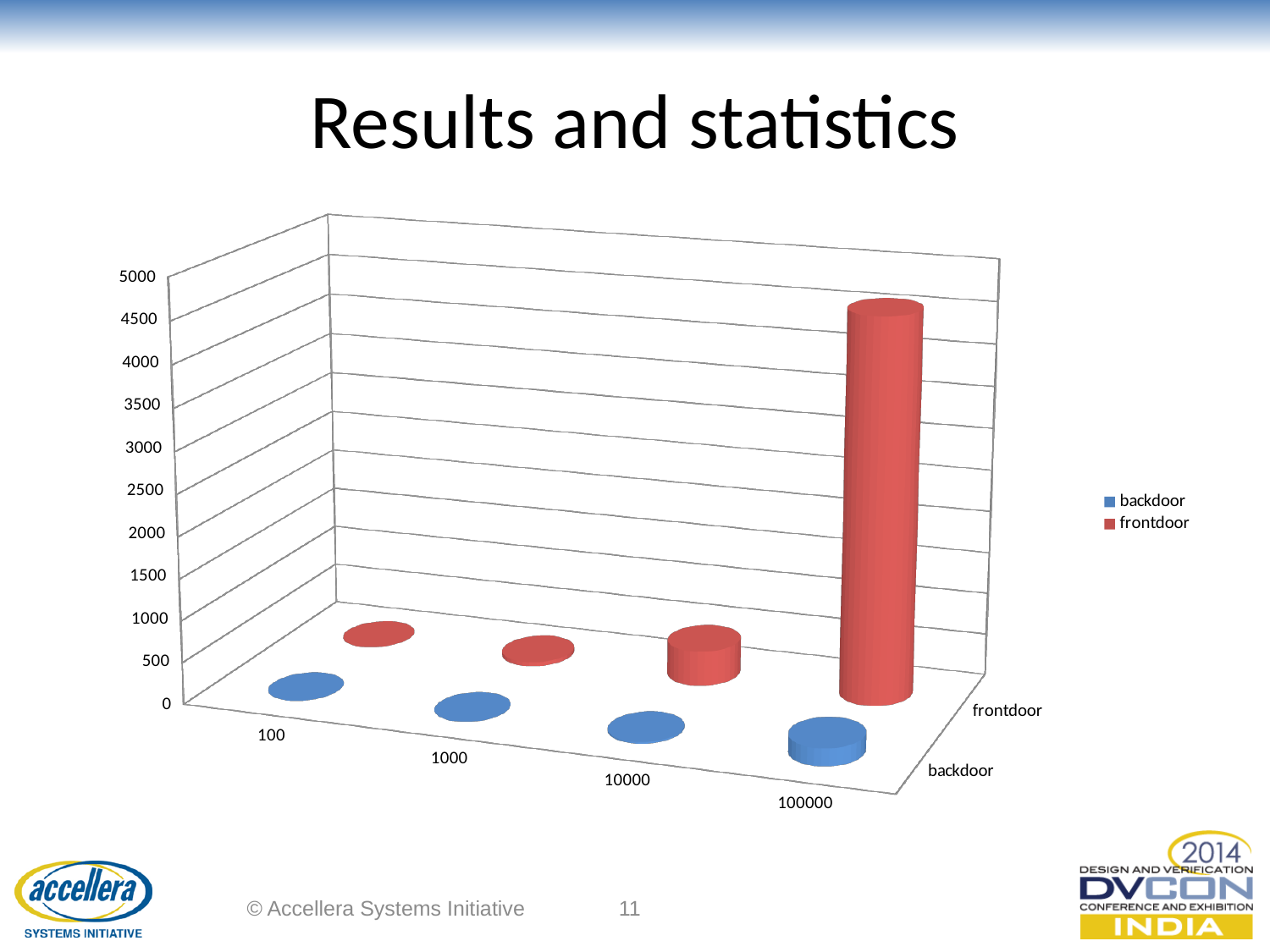
How many series does the chart's legend list? 2 How many categories are shown along the x axis of the chart? 4 Which category has the highest backdoor value? 100000 Is the backdoor value for 100000 greater or less than 500? less Which category has the highest frontdoor value? 100000 Do the frontdoor values rise or fall as the categories go from 100 to 100000? rise What colour represents the frontdoor series in the chart? red Is the frontdoor value for 10000 greater or less than 1000? less What are the two entries listed in the chart's legend? backdoor, frontdoor For the category 100000, which series has the larger value, backdoor or frontdoor? frontdoor Is the frontdoor value for 100000 greater or less than 3000? greater What kind of chart is shown on the slide? bar chart